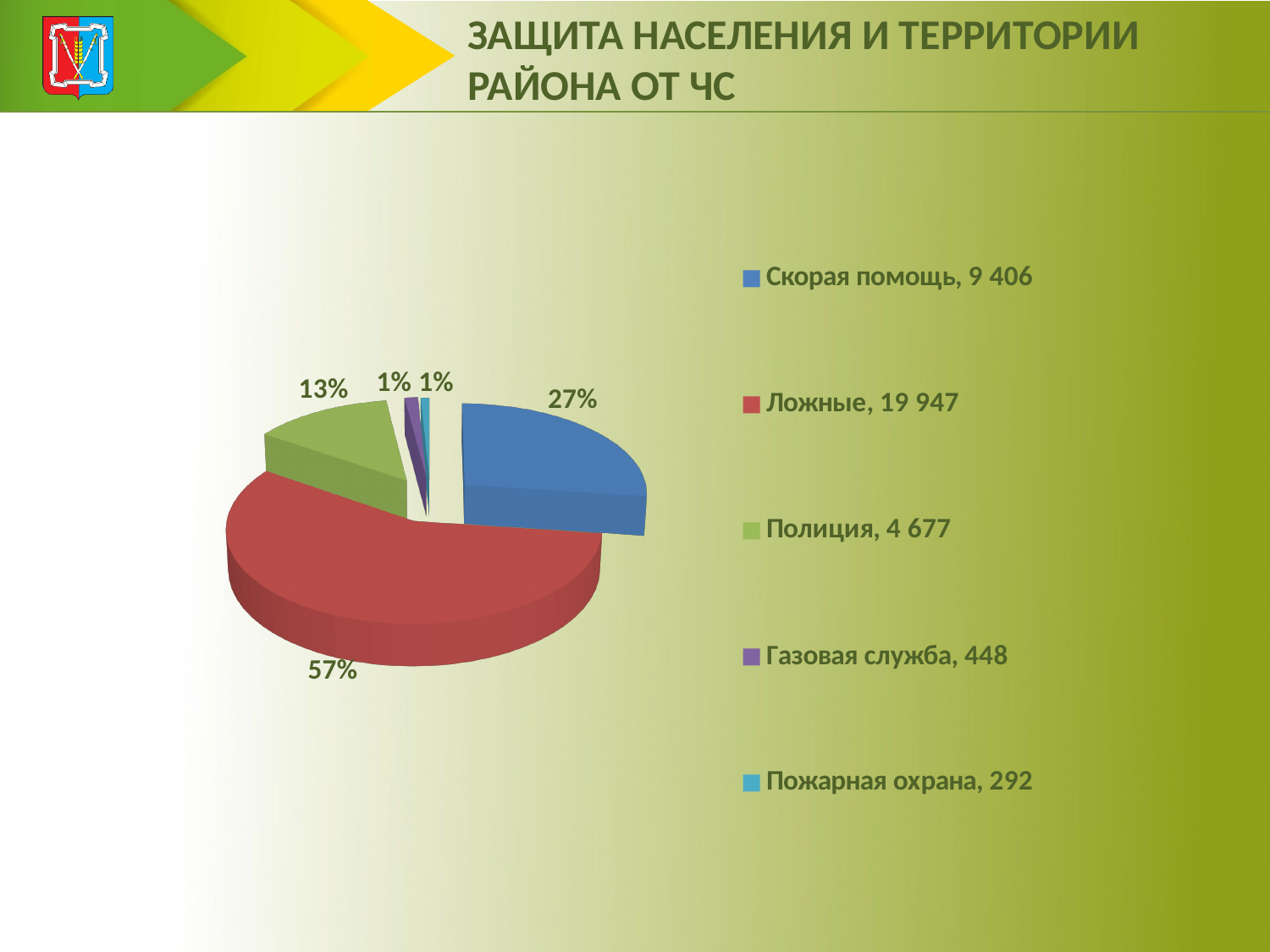
Which category has the largest slice of the pie? Ложные What value is shown in the legend for Пожарная охрана? 292 How many categories does the pie chart show? 5 Which category has the smallest slice of the pie? Пожарная охрана What share of the pie does Полиция account for? 13% What value is shown in the legend for Ложные? 19 947 What is the difference between the values for Ложные and Скорая помощь? 10 541 What value is shown in the legend for Скорая помощь? 9 406 What share of the pie does Ложные account for? 57% What value is shown in the legend for Полиция? 4 677 What kind of chart is shown on the slide? Pie chart Which is larger, the value for Газовая служба or the value for Пожарная охрана? Газовая служба